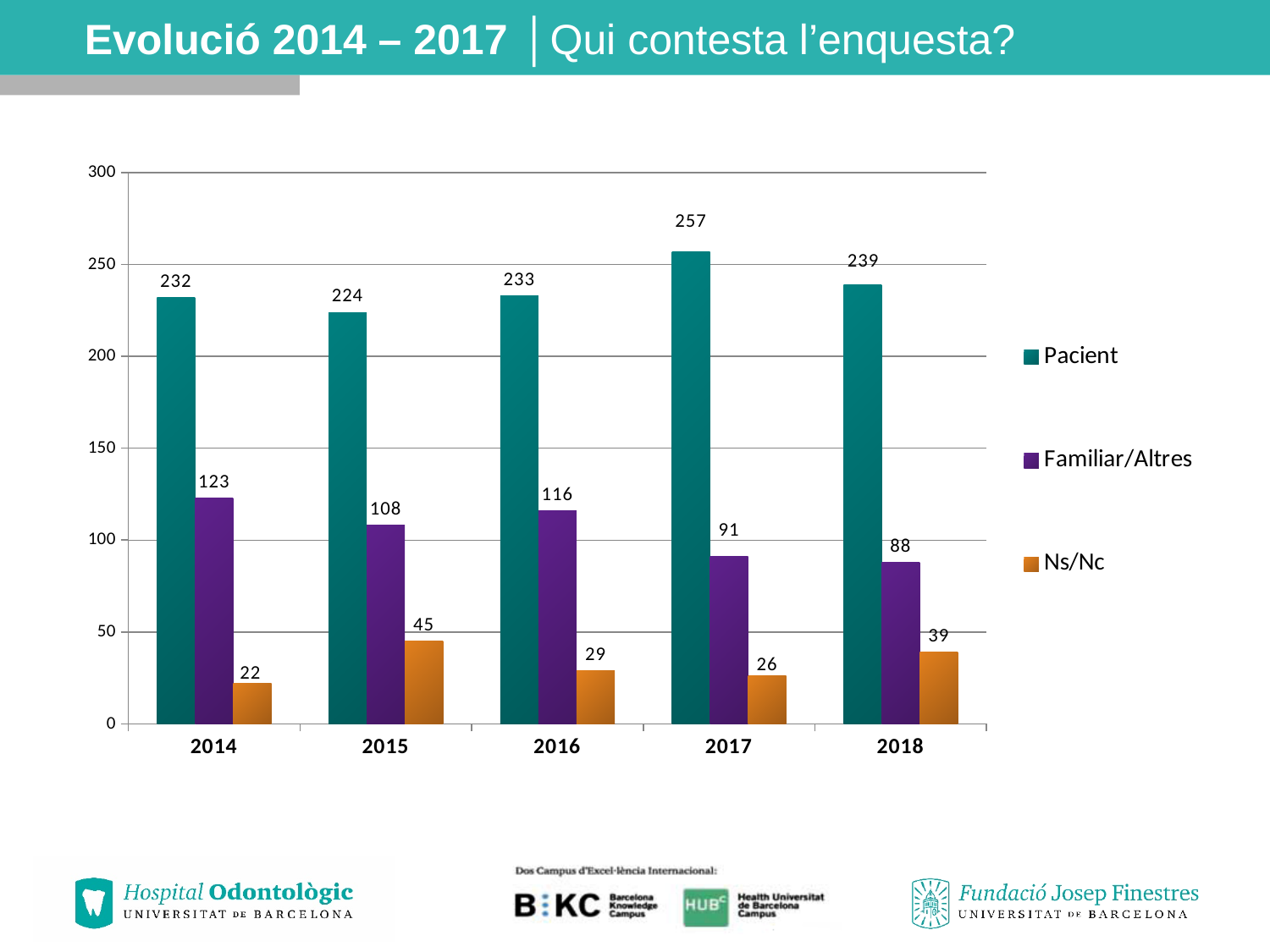
What kind of chart is shown on the slide? Bar chart In which year is the Pacient value highest? 2017 What is the value for Familiar/Altres in 2015? 108 In which year is the Ns/Nc value lowest? 2014 How many series does the legend list? 3 What is the value for Pacient in 2017? 257 Does the Familiar/Altres value rise or fall from 2016 to 2018? Fall Which is larger: Familiar/Altres in 2016 or Familiar/Altres in 2017? Familiar/Altres in 2016 How many years are shown on the x axis? 5 What is the value for Ns/Nc in 2018? 39 Is the value for Pacient in 2018 greater or less than 200? greater What is the difference between the Pacient value in 2017 and the Pacient value in 2014? 25